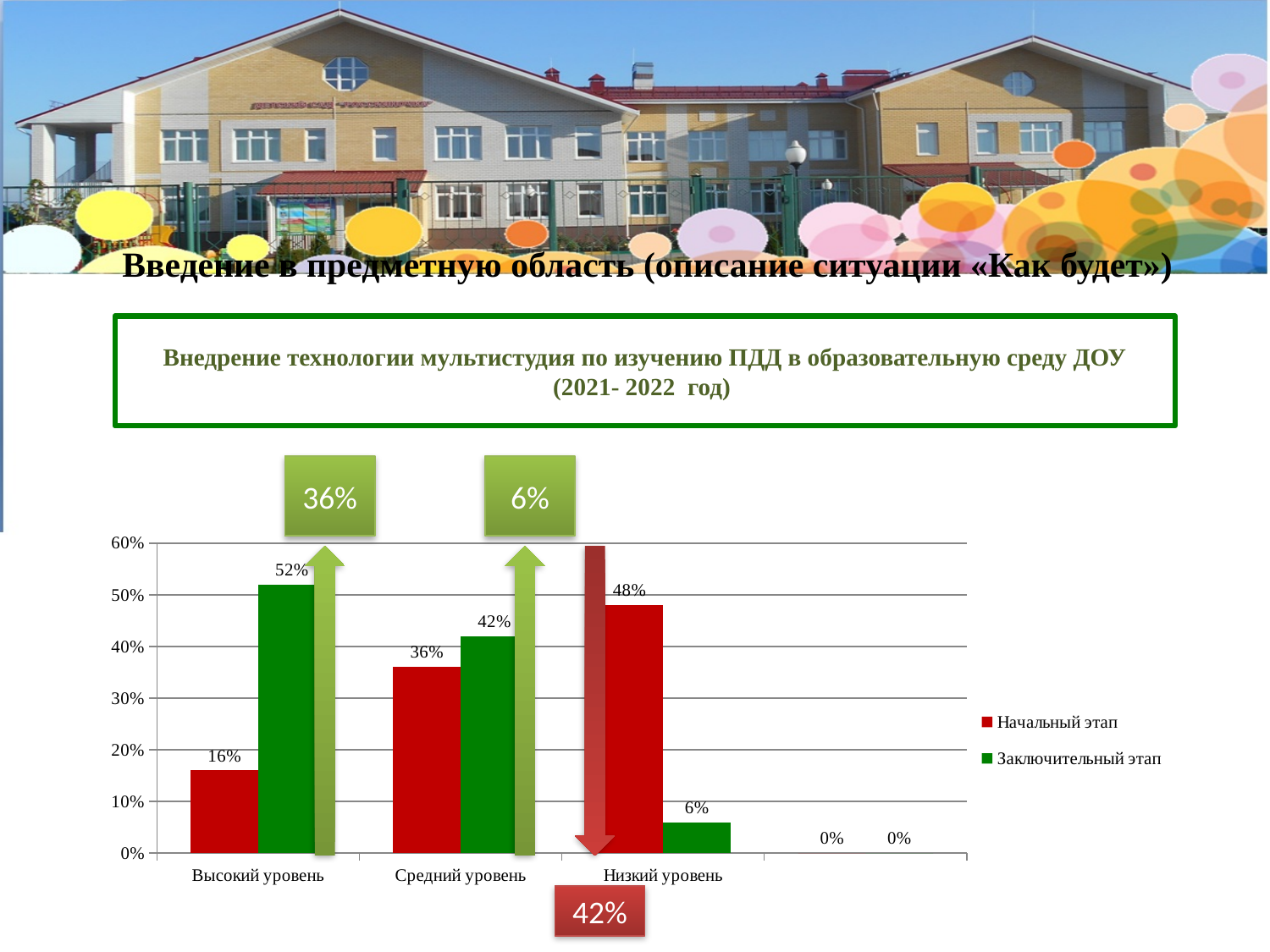
What is the value for Низкий уровень in the Заключительный этап series? 6% What is the difference between the Заключительный этап and Начальный этап values for Высокий уровень? 36% Which is larger for Средний уровень: the Начальный этап value or the Заключительный этап value? Заключительный этап What colour are the bars for the Начальный этап series? Red What is the value for Высокий уровень in the Заключительный этап series? 52% What kind of chart is shown on the slide? Bar chart What is the value for Высокий уровень in the Начальный этап series? 16% How many series does the legend list? 2 Which category has the lowest value in the Заключительный этап series? Низкий уровень Which category has the highest value in the Начальный этап series? Низкий уровень What is the difference between the Начальный этап and Заключительный этап values for Низкий уровень? 42% What is the value for Средний уровень in the Начальный этап series? 36%